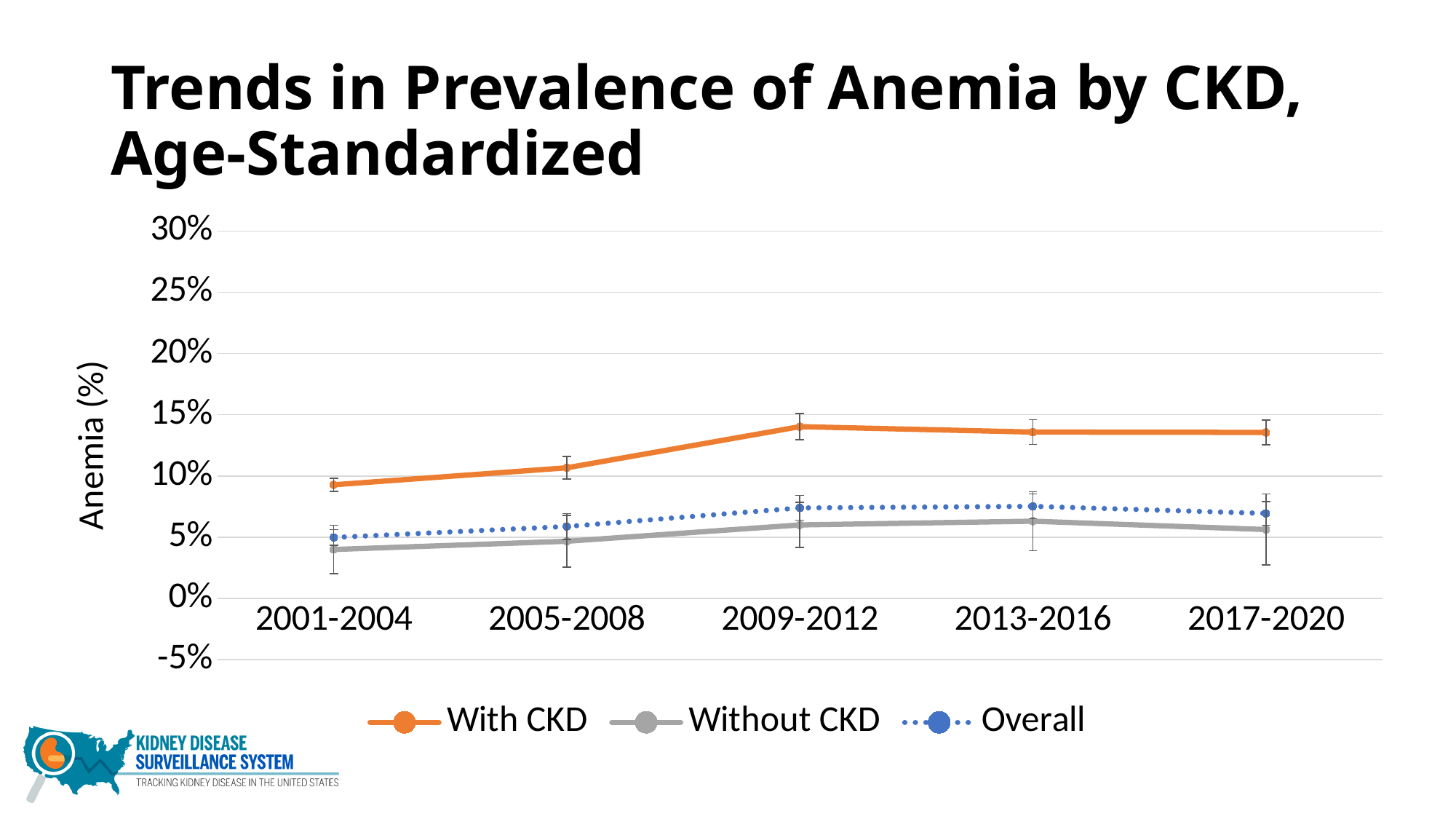
How many series does the legend list? 3 In which period is the With CKD series at its lowest? 2001-2004 Is the value for With CKD in 2017-2020 greater or less than 15%? less How many time periods are plotted along the x axis? 5 What kind of chart is shown on the slide? line chart Does the With CKD series rise or fall from 2001-2004 to 2009-2012? rise In 2009-2012, which is larger: the value for With CKD or the value for Without CKD? With CKD Is the value for Overall in 2013-2016 greater or less than 5%? greater Is the value for Without CKD in 2001-2004 greater or less than 5%? less What is the label on the y axis? Anemia (%)